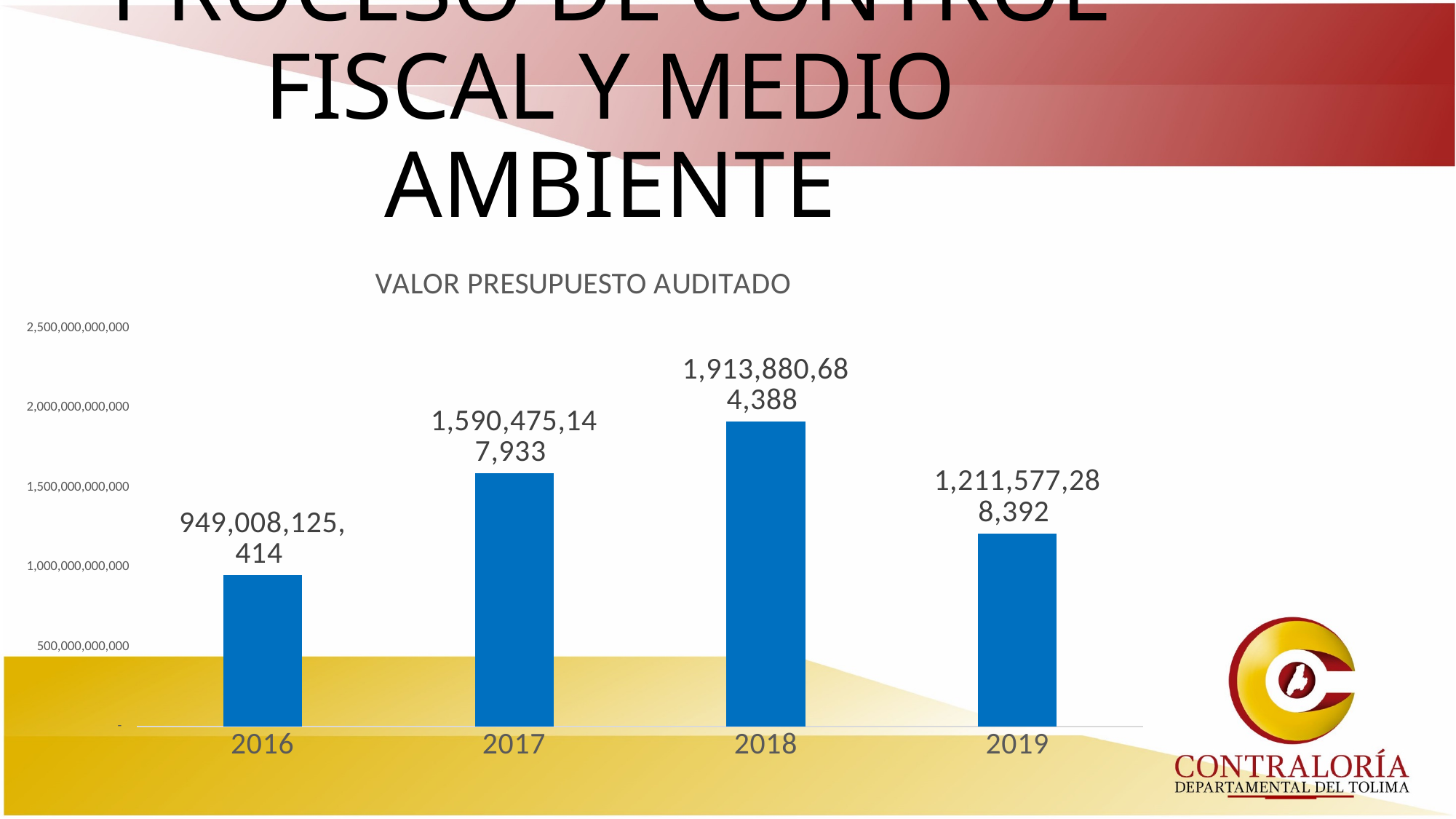
What is the value for 2019 in the VALOR PRESUPUESTO AUDITADO chart? 1,211,577,288,392 What is the value for 2016 in the VALOR PRESUPUESTO AUDITADO chart? 949,008,125,414 Which is larger in the VALOR PRESUPUESTO AUDITADO chart, the value for 2017 or the value for 2019? 2017 What kind of chart is the VALOR PRESUPUESTO AUDITADO chart? bar chart What is the title of the chart on the slide? VALOR PRESUPUESTO AUDITADO Is the value for 2016 in the VALOR PRESUPUESTO AUDITADO chart greater or less than 1,000,000,000,000? less Which year has the highest value in the VALOR PRESUPUESTO AUDITADO chart? 2018 How many years are shown on the x axis of the VALOR PRESUPUESTO AUDITADO chart? 4 Which year has the lowest value in the VALOR PRESUPUESTO AUDITADO chart? 2016 What is the difference between the values for 2018 and 2017 in the VALOR PRESUPUESTO AUDITADO chart? 323,405,536,455 What is the value for 2018 in the VALOR PRESUPUESTO AUDITADO chart? 1,913,880,684,388 What is the difference between the values for 2017 and 2016 in the VALOR PRESUPUESTO AUDITADO chart? 641,467,022,519